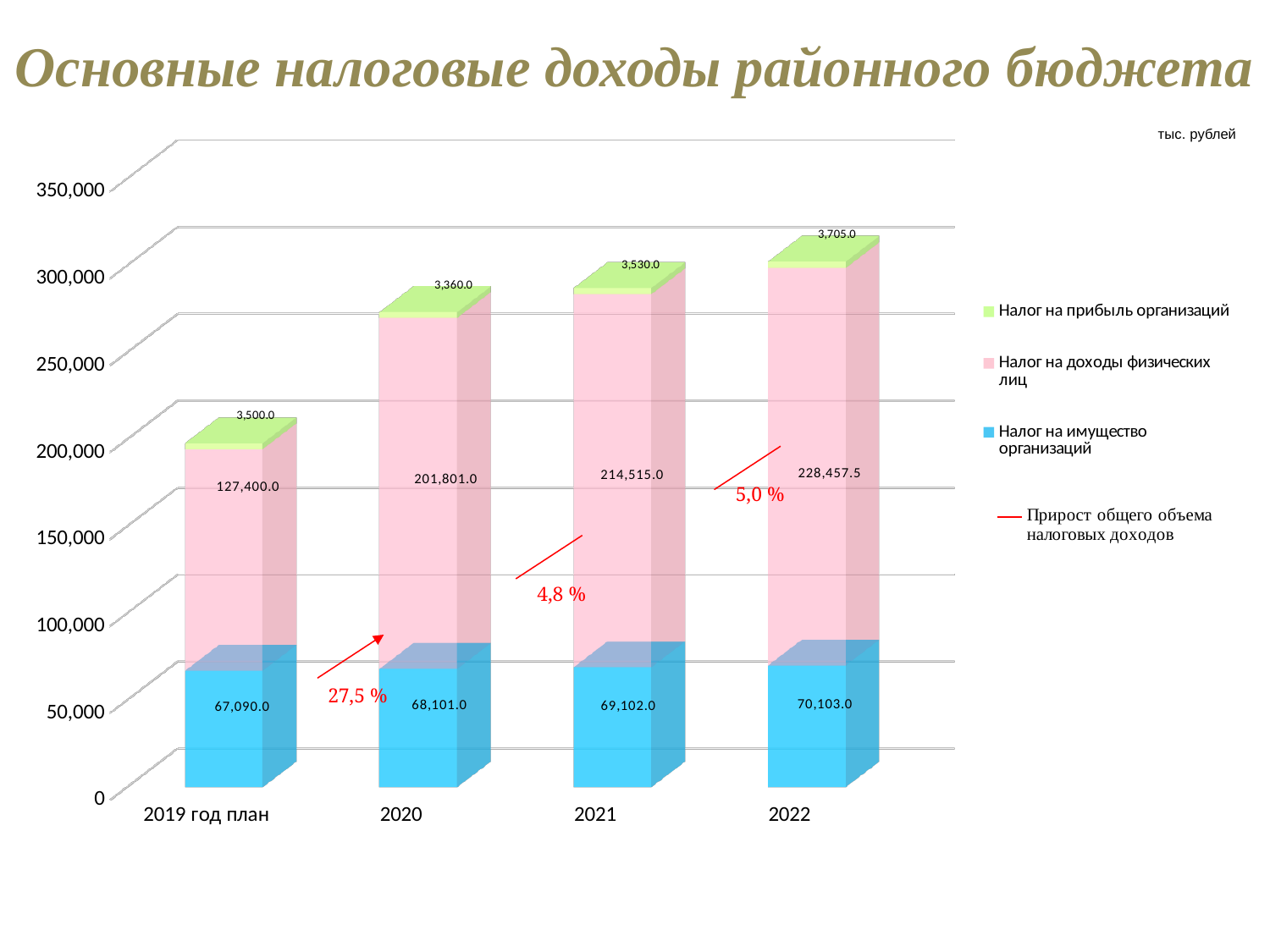
What is the value of Налог на прибыль организаций for 2021? 3,530.0 Which year has the highest value for Налог на доходы физических лиц? 2022 What is the value of Налог на имущество организаций for 2019 год план? 67,090.0 Which is larger: Налог на имущество организаций in 2021 or in 2020? 2021 What is the total of the stacked bar for 2021? 287,147.0 Which year has the lowest value for Налог на прибыль организаций? 2020 How many years (categories) are shown on the x axis? 4 What is the difference between Налог на доходы физических лиц in 2020 and in 2019 год план? 74,401.0 Is the total height of the 2022 stacked bar greater or less than 300,000? greater How many entries does the legend list? 4 What is the value of Налог на доходы физических лиц for 2022? 228,457.5 What kind of chart is shown on the slide? Stacked bar chart